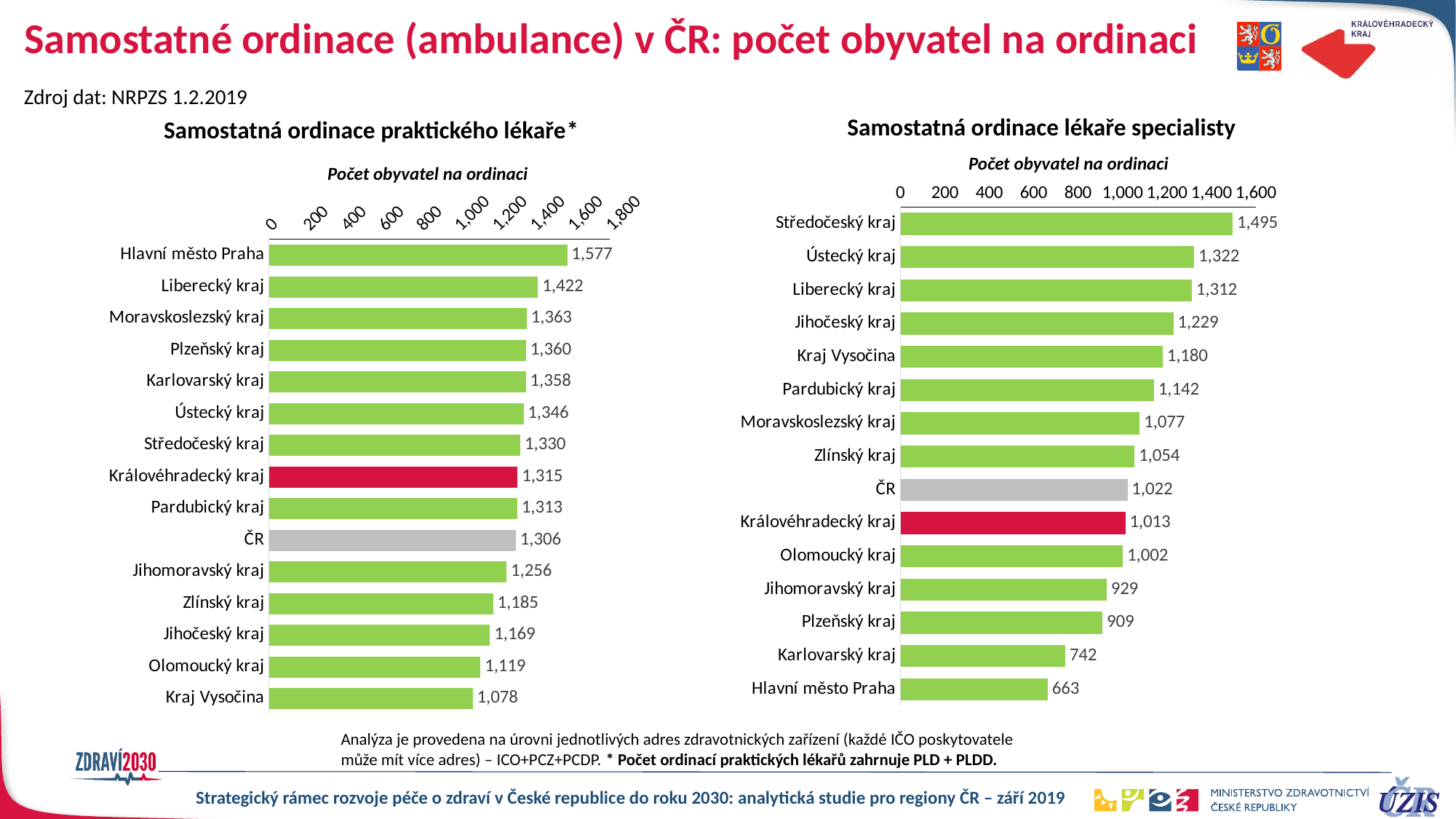
In the chart 'Samostatná ordinace praktického lékaře*', what is the value for Hlavní město Praha? 1,577 In the chart 'Samostatná ordinace lékaře specialisty', what is the difference between ČR and Královéhradecký kraj? 9 In the chart 'Samostatná ordinace praktického lékaře*', is the value for Liberecký kraj greater or less than 1,400? greater In the chart 'Samostatná ordinace praktického lékaře*', what is the difference between Hlavní město Praha and Kraj Vysočina? 499 In the chart 'Samostatná ordinace lékaře specialisty', which is larger, Karlovarský kraj or Plzeňský kraj? Plzeňský kraj In the chart 'Samostatná ordinace praktického lékaře*', which category has the lowest value? Kraj Vysočina In the chart 'Samostatná ordinace lékaře specialisty', which category has the lowest value? Hlavní město Praha What kind of chart is 'Samostatná ordinace praktického lékaře*'? Bar chart In the chart 'Samostatná ordinace praktického lékaře*', which bar is coloured red? Královéhradecký kraj In the chart 'Samostatná ordinace lékaře specialisty', what is the value for Královéhradecký kraj? 1,013 How many categories are shown in the chart 'Samostatná ordinace lékaře specialisty'? 15 In the chart 'Samostatná ordinace lékaře specialisty', which category has the highest value? Středočeský kraj